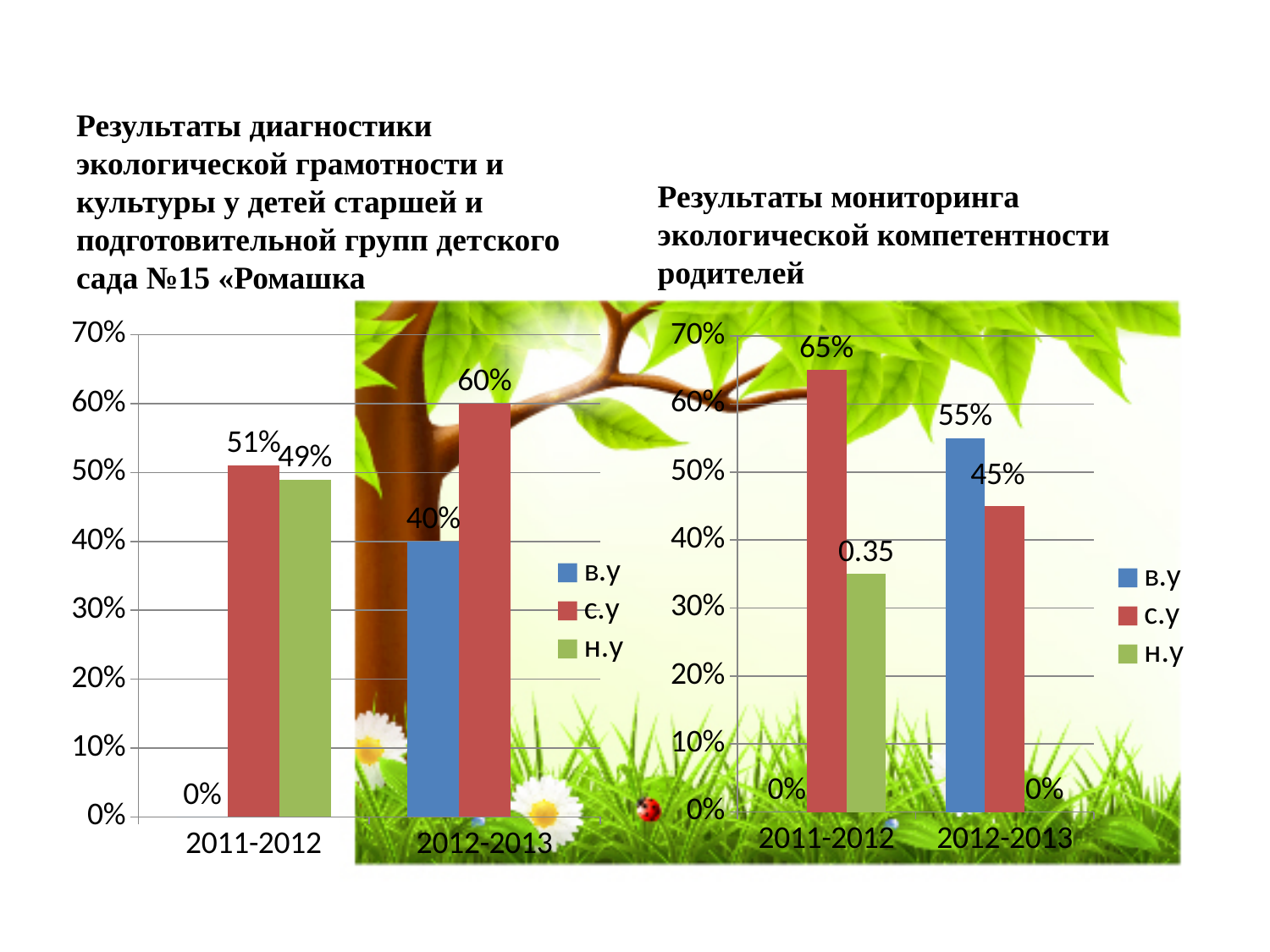
In the right chart (parents' monitoring), what is the value for с.у in 2012-2013? 45% What kind of chart is the left chart (children's diagnostics)? Bar chart In the left chart (children's diagnostics), what is the value for с.у in 2012-2013? 60% In the left chart (children's diagnostics), what is the value for с.у in 2011-2012? 51% In the left chart (children's diagnostics), what is the value for в.у in 2012-2013? 40% How many series does the legend of the right chart (parents' monitoring) list? 3 In the right chart (parents' monitoring), what is the difference between в.у and с.у in 2012-2013? 10% In the right chart (parents' monitoring), what is the value for с.у in 2011-2012? 65% In the left chart (children's diagnostics), what is the value for н.у in 2011-2012? 49% In the left chart (children's diagnostics), what is the difference between с.у in 2012-2013 and с.у in 2011-2012? 9% In the right chart (parents' monitoring), which is larger in 2012-2013: в.у or с.у? в.у In the right chart (parents' monitoring), what is the value for в.у in 2012-2013? 55%